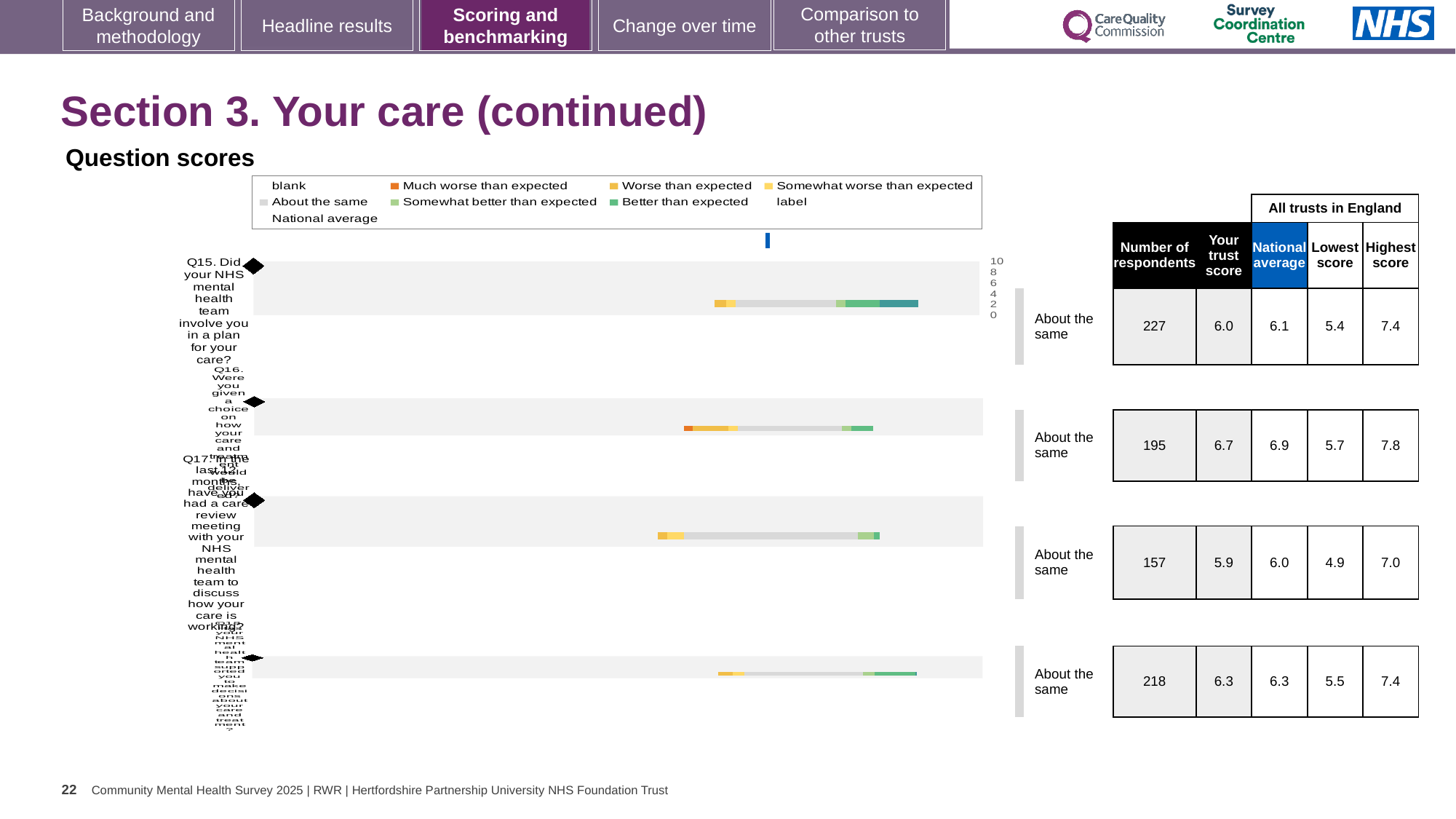
Which of Q15, Q16 and Q17 has the lowest trust score? Q17 What kind of chart is used to show the question scores on this slide? bar chart What is the trust score for Q16 (Were you given a choice on how your care and treatment would be delivered)? 6.7 What is the highest score among all trusts in England for Q16? 7.8 How many entries does the legend of the question scores chart list? 9 What is the national average for Q17 (In the last 12 months, have you had a care review meeting)? 6.0 What is the number of respondents for Q15 (Did your NHS mental health team involve you in a plan for your care?)? 227 In the legend of the question scores chart, which entry is shown in orange? Much worse than expected What is the difference between the highest score and the lowest score for Q16? 2.1 Which of Q15, Q16 and Q17 has the highest number of respondents? Q15 How many question rows (bars) are plotted in the question scores chart? 4 For Q16, which is larger: the trust score or the national average? National average